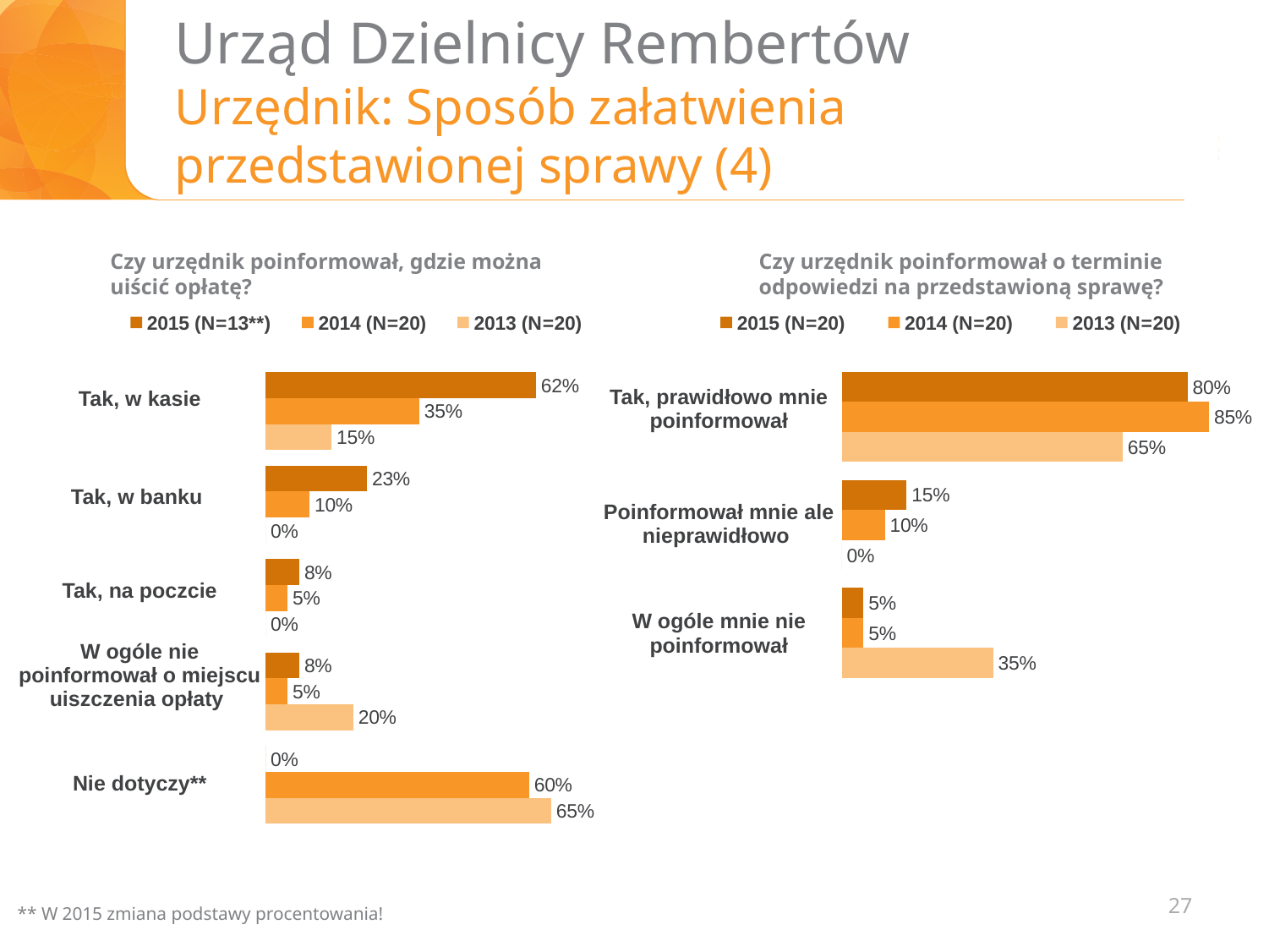
In the right chart ("Czy urzędnik poinformował o terminie odpowiedzi na przedstawioną sprawę?"), which is larger for "Tak, prawidłowo mnie poinformował": the 2015 value or the 2013 value? 2015 In the left chart ("Czy urzędnik poinformował, gdzie można uiścić opłatę?"), what sample size does the legend give for 2015? N=13** In the left chart ("Czy urzędnik poinformował, gdzie można uiścić opłatę?"), what is the difference between the 2015 and 2014 values for "Tak, w kasie"? 27 percentage points In the right chart ("Czy urzędnik poinformował o terminie odpowiedzi na przedstawioną sprawę?"), what is the 2014 value for "Tak, prawidłowo mnie poinformował"? 85% In the right chart ("Czy urzędnik poinformował o terminie odpowiedzi na przedstawioną sprawę?"), what is the difference between the 2013 and 2015 values for "W ogóle mnie nie poinformował"? 30 percentage points In the left chart ("Czy urzędnik poinformował, gdzie można uiścić opłatę?"), how many series does the legend list? 3 In the left chart ("Czy urzędnik poinformował, gdzie można uiścić opłatę?"), which category has the highest 2014 value? Nie dotyczy** What type of chart is the right chart ("Czy urzędnik poinformował o terminie odpowiedzi na przedstawioną sprawę?")? Bar chart In the right chart ("Czy urzędnik poinformował o terminie odpowiedzi na przedstawioną sprawę?"), what is the 2013 value for "W ogóle mnie nie poinformował"? 35% In the left chart ("Czy urzędnik poinformował, gdzie można uiścić opłatę?"), how many categories are shown? 5 In the left chart ("Czy urzędnik poinformował, gdzie można uiścić opłatę?"), what is the 2015 value for "Tak, w kasie"? 62% In the left chart ("Czy urzędnik poinformował, gdzie można uiścić opłatę?"), what is the 2013 value for "Nie dotyczy**"? 65%